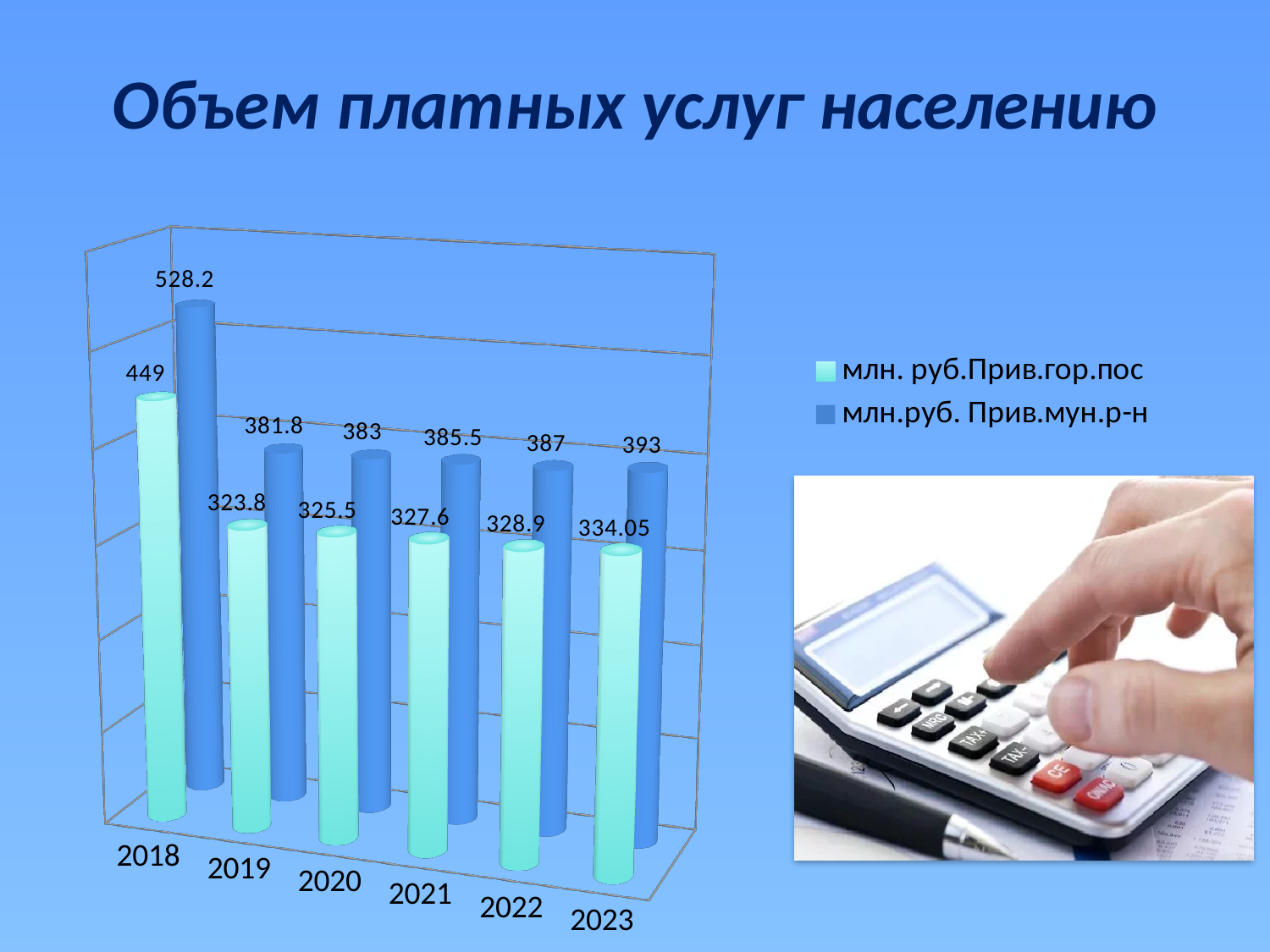
What is the title of the chart? Объем платных услуг населению What is the value for млн.руб. Прив.мун.р-н in 2018? 528.2 What is the difference between the two series' values in 2023? 58.95 What is the value for млн.руб. Прив.мун.р-н in 2021? 385.5 What is the value for млн. руб.Прив.гор.пос in 2023? 334.05 How many series does the legend list? 2 In which year is the value for млн.руб. Прив.мун.р-н the highest? 2018 What is the value for млн. руб.Прив.гор.пос in 2020? 325.5 In which year is the value for млн. руб.Прив.гор.пос the lowest? 2019 What is the difference between the млн.руб. Прив.мун.р-н values in 2018 and 2019? 146.4 How many years are shown on the x axis? 6 Which is larger in 2022: млн. руб.Прив.гор.пос or млн.руб. Прив.мун.р-н? млн.руб. Прив.мун.р-н